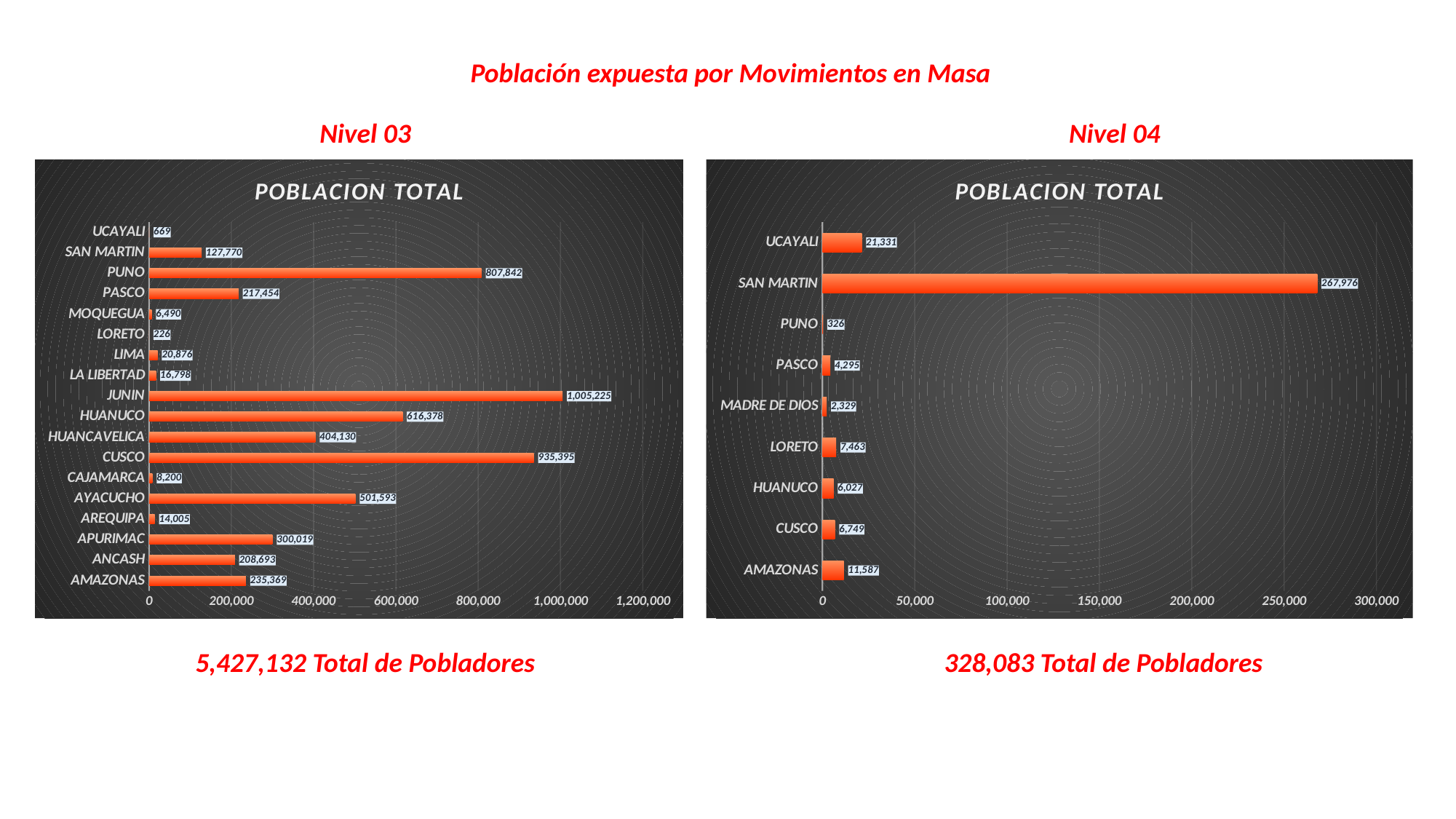
In the Nivel 03 chart on the left, what is the value for JUNIN? 1,005,225 In the Nivel 04 chart on the right, what is the value for AMAZONAS? 11,587 In the Nivel 03 chart on the left, which category has the lowest value? LORETO In the Nivel 04 chart on the right, what is the difference between the values for SAN MARTIN and UCAYALI? 246,645 In the Nivel 04 chart on the right, which category has the lowest value? PUNO In the Nivel 04 chart on the right, what is the value for SAN MARTIN? 267,976 In the Nivel 03 chart on the left, what is the difference between the values for JUNIN and CUSCO? 69,830 In the Nivel 03 chart on the left, which category has the highest value? JUNIN What kind of chart is the Nivel 03 chart on the left? Bar chart In the Nivel 03 chart on the left, which is larger, the value for PUNO or the value for HUANUCO? PUNO In the Nivel 03 chart on the left, what is the value for HUANCAVELICA? 404,130 How many categories are shown in the Nivel 04 chart on the right? 9